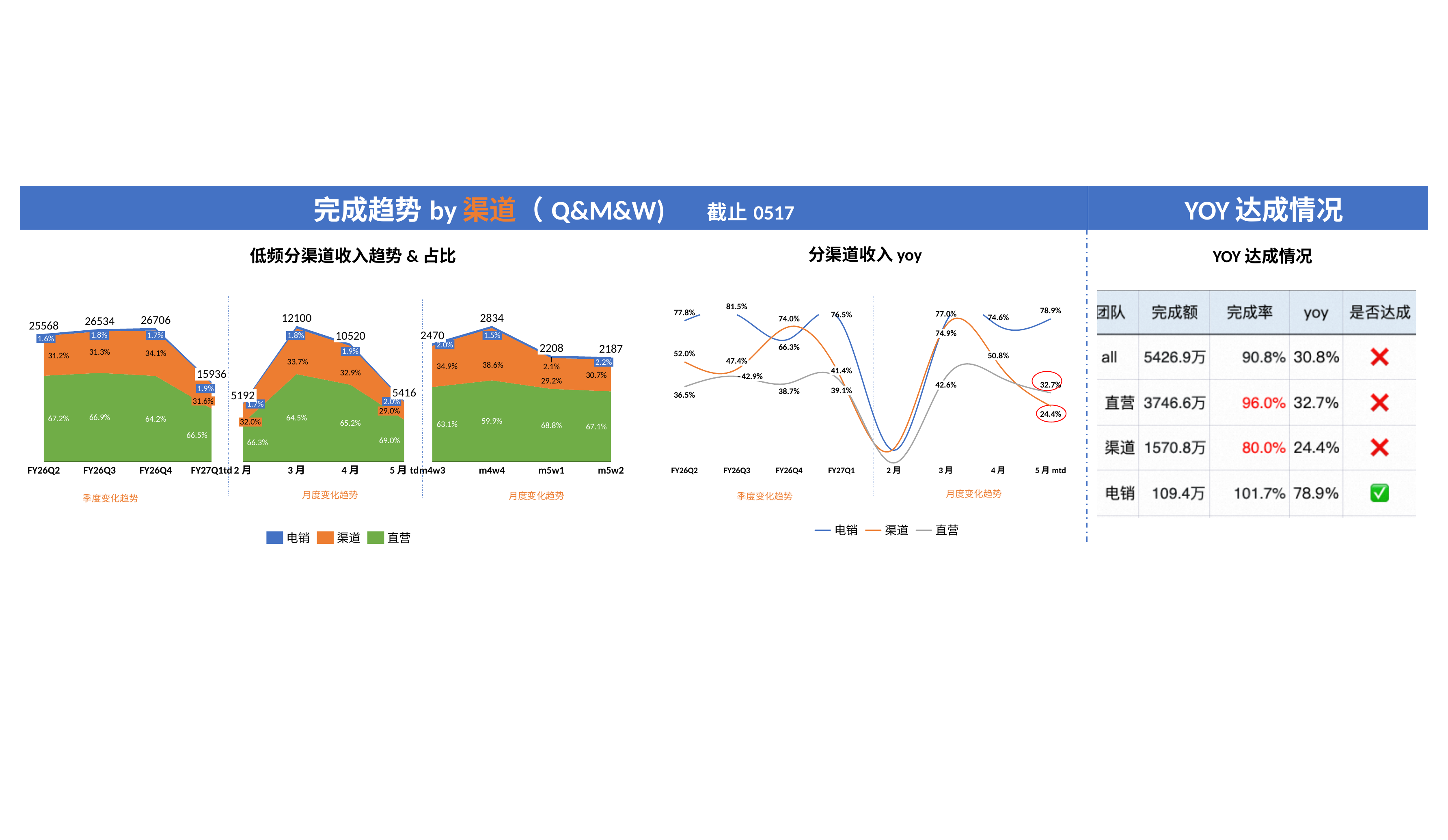
In the middle chart 分渠道收入 yoy, what is the value for 电销 in FY26Q3? 81.5% What kind of chart is the left chart titled 低频分渠道收入趋势 & 占比? stacked area chart In the middle chart 分渠道收入 yoy, what is the value for 渠道 at 5月 mtd? 24.4% In the left chart 低频分渠道收入趋势 & 占比, what share does 直营 have in FY26Q2? 67.2% In the left chart 低频分渠道收入趋势 & 占比, what is the difference between the totals for 3月 and 4月? 1580 In the left chart 低频分渠道收入趋势 & 占比, which quarter among FY26Q2, FY26Q3, FY26Q4 and FY27Q1td has the highest total? FY26Q4 In the middle chart 分渠道收入 yoy, which is larger in FY26Q2, 电销 or 直营? 电销 In the left chart 低频分渠道收入趋势 & 占比, what is the total value labeled for 3月? 12100 In the left chart 低频分渠道收入趋势 & 占比, what is the total value labeled for FY26Q4? 26706 In the left chart 低频分渠道收入趋势 & 占比, which week among m4w3, m4w4, m5w1 and m5w2 has the highest total? m4w4 How many series does the legend of the left chart 低频分渠道收入趋势 & 占比 list? 3 In the middle chart 分渠道收入 yoy, in which quarter among FY26Q2, FY26Q3, FY26Q4 and FY27Q1 is 电销 highest? FY26Q3